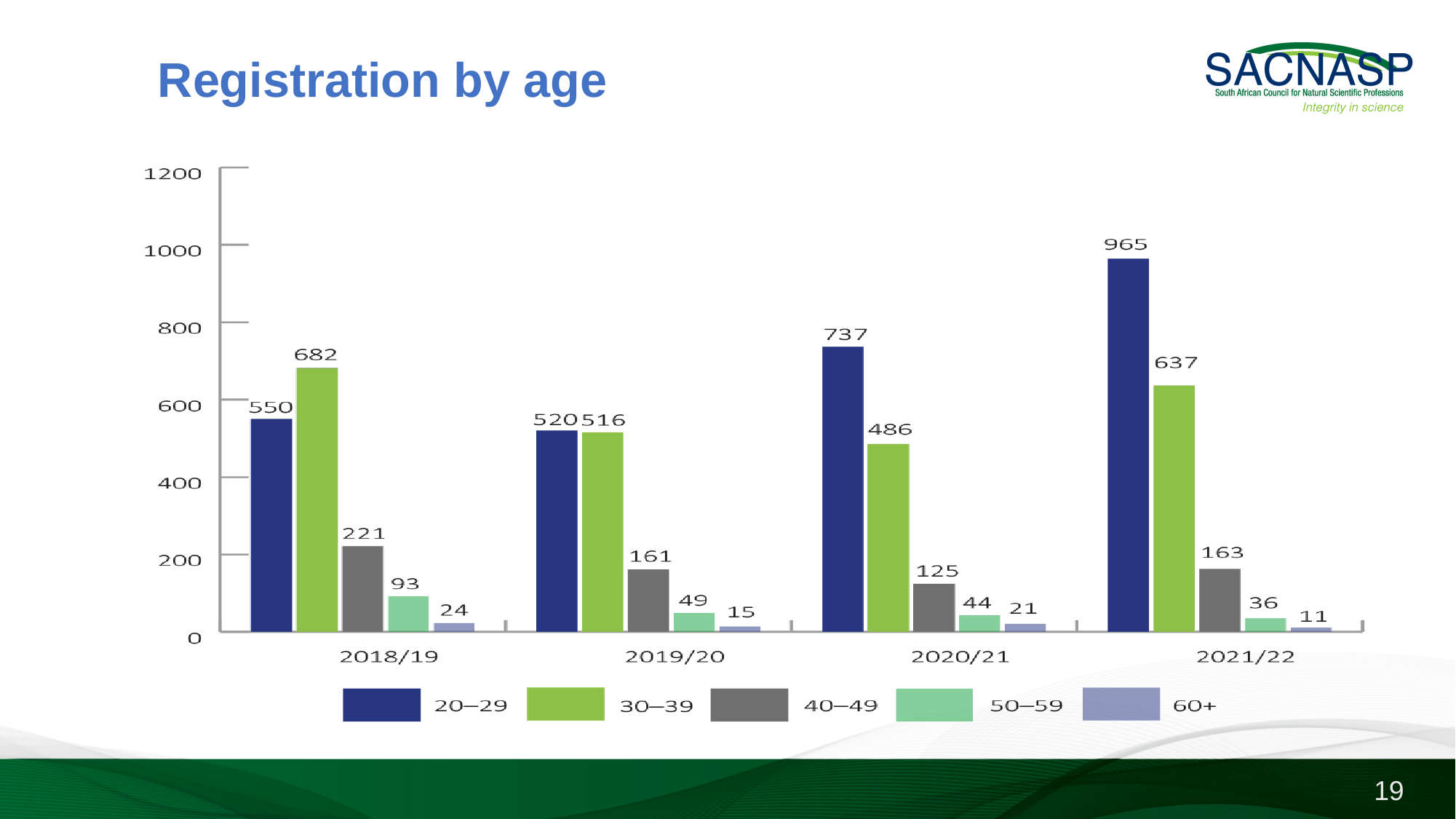
Which year has the highest value for the 30–39 age group? 2018/19 What is the value for the 40–49 age group in 2018/19? 221 What kind of chart is shown on the slide? Bar chart Which is larger in 2018/19: the 20–29 value or the 30–39 value? 30–39 How many series does the legend list? 5 What is the title of the slide? Registration by age Which year has the lowest value for the 50–59 age group? 2021/22 What is the difference between the 20–29 and 30–39 values in 2020/21? 251 Do the values for the 40–49 age group rise or fall from 2018/19 to 2020/21? Fall How many years are shown on the x axis? 4 What is the value for the 20–29 age group in 2021/22? 965 What is the value for the 60+ age group in 2019/20? 15